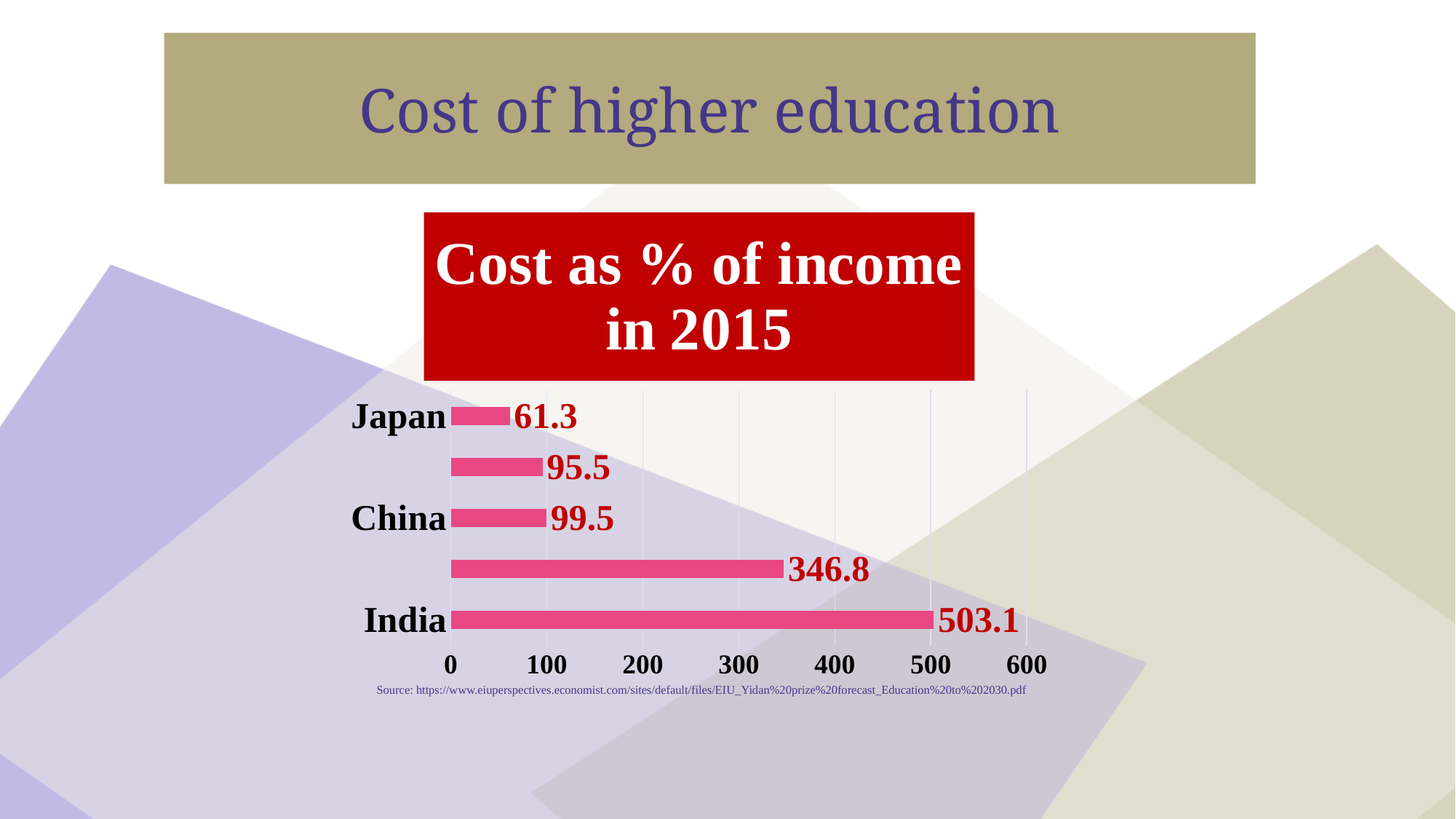
Is the value for India greater or less than 400? greater What kind of chart is shown on the slide? Bar chart What is the difference between the values for China and Japan? 38.2 What is the value for China? 99.5 What is the difference between the values for India and China? 403.6 What is the title of the chart? Cost as % of income in 2015 How many bars are plotted in the chart? 5 Which country has the highest value? India What is the value for Japan? 61.3 Which is larger, the value for China or the value for Japan? China Which country has the lowest value? Japan What is the value for India? 503.1